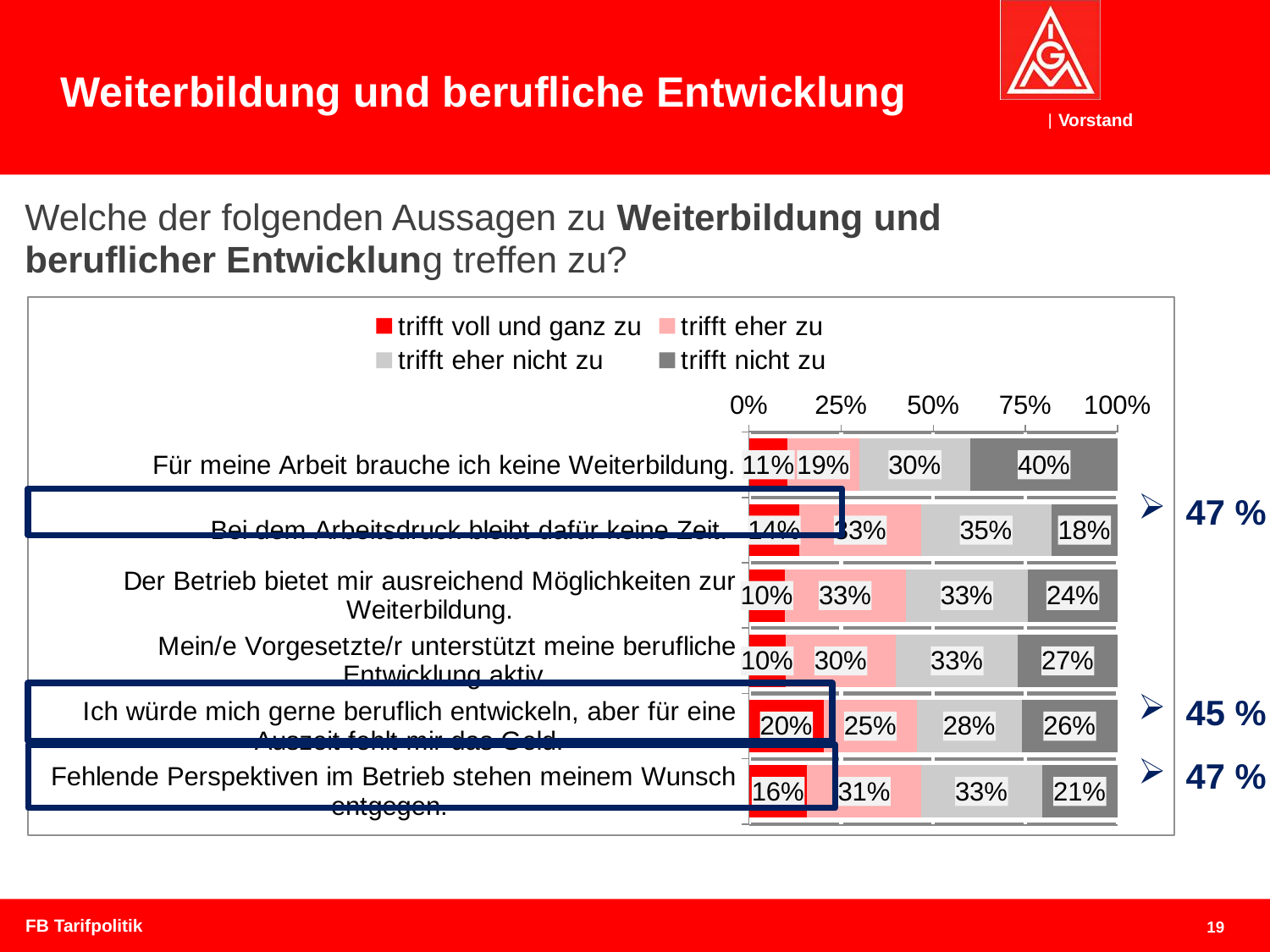
What is the 'trifft eher nicht zu' value for 'Fehlende Perspektiven im Betrieb stehen meinem Wunsch entgegen.'? 33% What colour does the legend use for the series 'trifft voll und ganz zu'? red Which statement has the highest 'trifft nicht zu' value? Für meine Arbeit brauche ich keine Weiterbildung. Which has the larger 'trifft eher zu' value: 'Mein/e Vorgesetzte/r unterstützt meine berufliche Entwicklung aktiv.' or 'Ich würde mich gerne beruflich entwickeln, aber für eine Auszeit fehlt mir das Geld.'? Mein/e Vorgesetzte/r unterstützt meine berufliche Entwicklung aktiv. What is the 'trifft nicht zu' value for 'Für meine Arbeit brauche ich keine Weiterbildung.'? 40% Which statement has the lowest 'trifft nicht zu' value? Bei dem Arbeitsdruck bleibt dafür keine Zeit. Which statement has the highest 'trifft voll und ganz zu' value? Ich würde mich gerne beruflich entwickeln, aber für eine Auszeit fehlt mir das Geld. How many statements (categories) are plotted in the chart? 6 What kind of chart is shown on the slide? stacked bar chart How many series does the legend of the chart list? 4 What is the 'trifft voll und ganz zu' value for 'Ich würde mich gerne beruflich entwickeln, aber für eine Auszeit fehlt mir das Geld.'? 20% What is the difference in percentage points between the 'trifft nicht zu' values for 'Für meine Arbeit brauche ich keine Weiterbildung.' and 'Bei dem Arbeitsdruck bleibt dafür keine Zeit.'? 22 percentage points